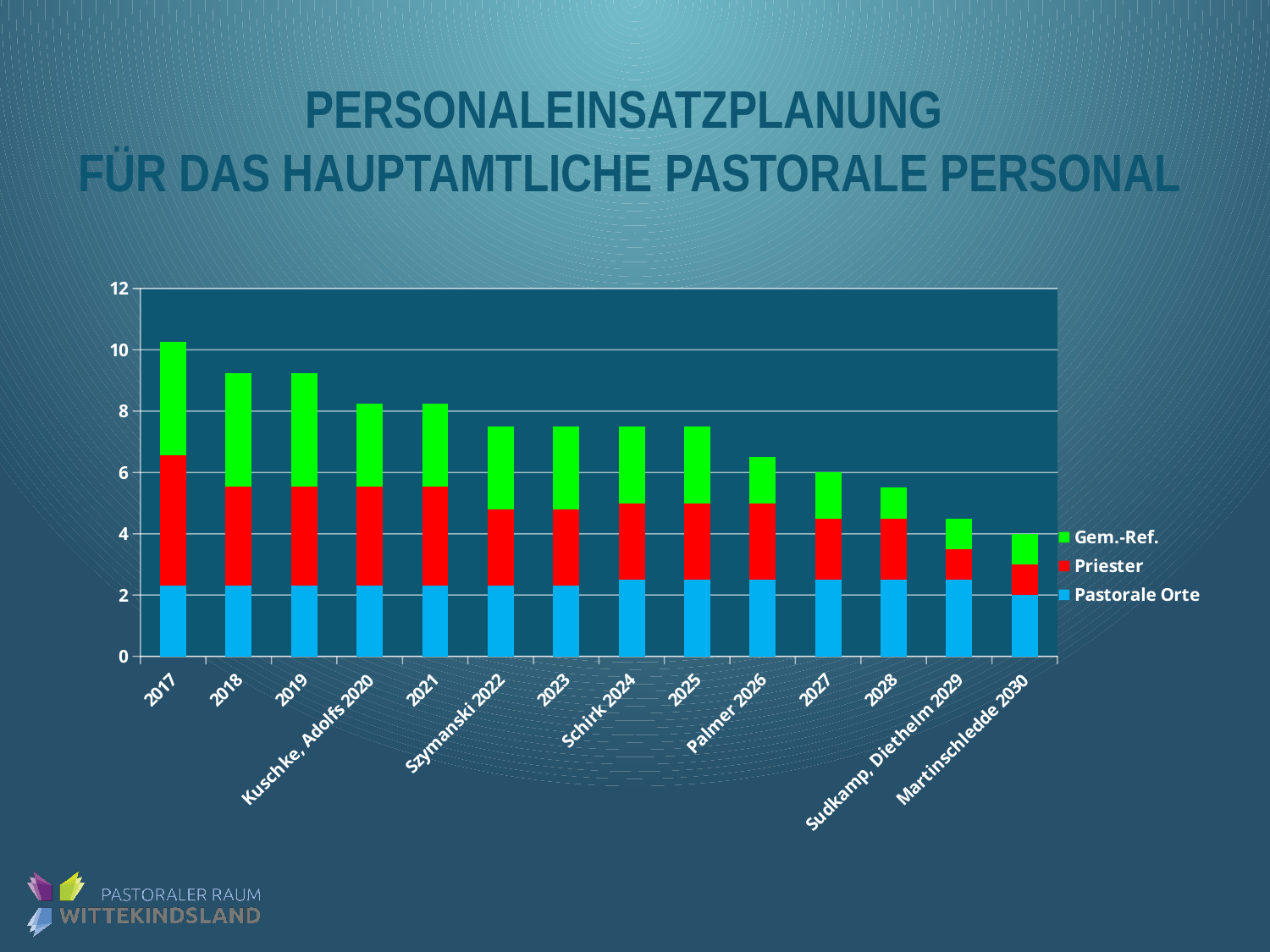
How many categories are shown along the x axis? 14 Which has the larger total bar, Palmer 2026 or 2028? Palmer 2026 Is the total bar for 2017 greater or less than 8? greater Which series is shown in green in the legend? Gem.-Ref. What kind of chart is shown on the slide? stacked bar chart Which category has the highest total bar? 2017 Do the total bar heights generally rise or fall from 2017 to Martinschledde 2030? fall Is the total bar for Sudkamp, Diethelm 2029 greater or less than 6? less Which category has the lowest total bar? Martinschledde 2030 Is the total bar for 2018 greater or less than 8? greater Which has the larger total bar, 2017 or 2018? 2017 How many series does the legend list? 3